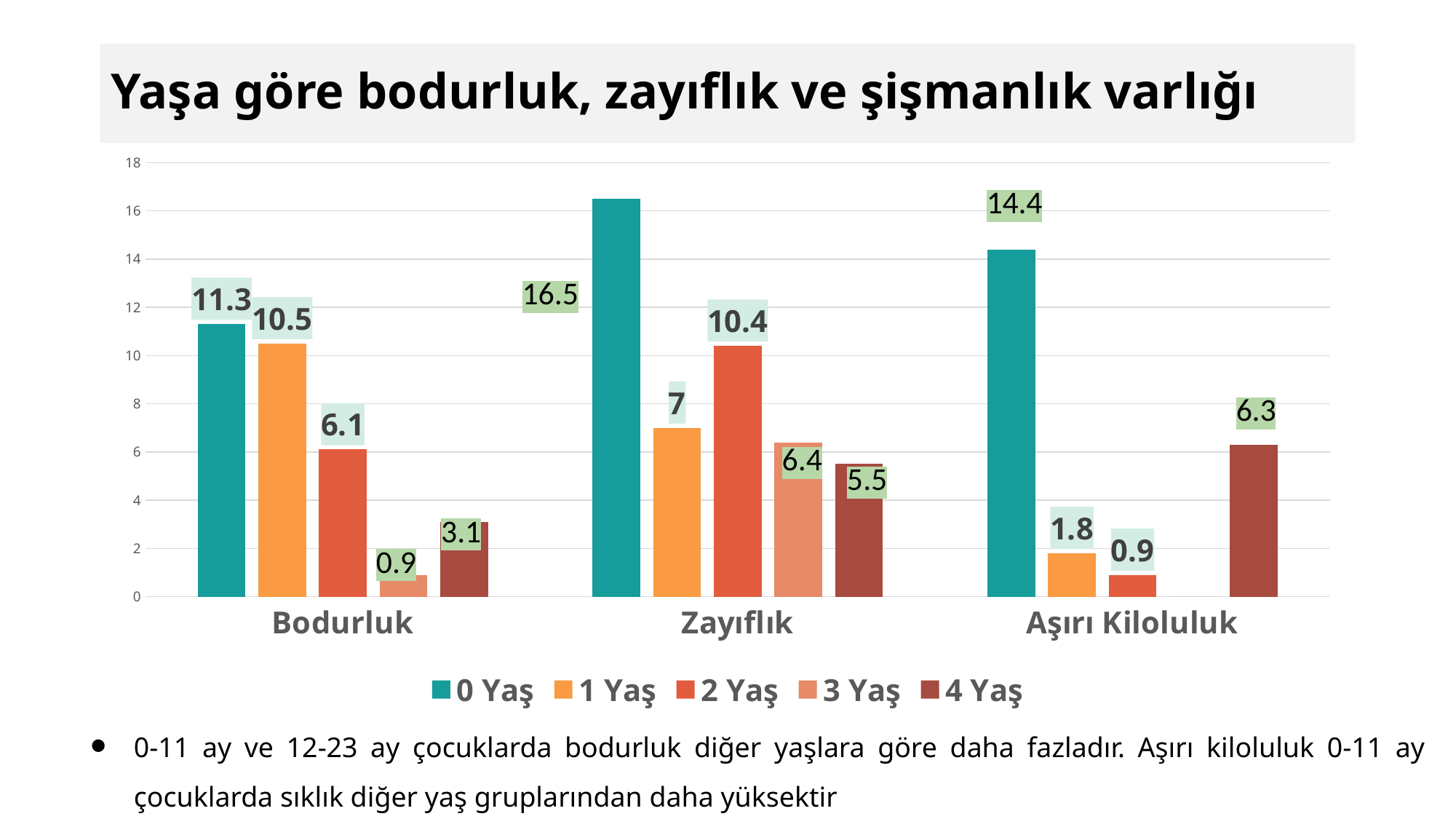
What kind of chart is shown on the slide? Bar chart What is the difference between the 0 Yaş and 1 Yaş values in the Aşırı Kiloluluk group? 12.6 What is the value for 1 Yaş in the Bodurluk group? 10.5 What is the title of the slide? Yaşa göre bodurluk, zayıflık ve şişmanlık varlığı Which age series has the highest value in the Zayıflık group? 0 Yaş How many categories are shown on the x axis? 3 Is the value for 0 Yaş in the Aşırı Kiloluluk group greater or less than 14? greater What is the value for 4 Yaş in the Aşırı Kiloluluk group? 6.3 Which is larger in the Zayıflık group: the 1 Yaş value or the 2 Yaş value? 2 Yaş How many series does the legend list? 5 Which age series has the lowest value in the Bodurluk group? 3 Yaş What is the value for 0 Yaş in the Zayıflık group? 16.5